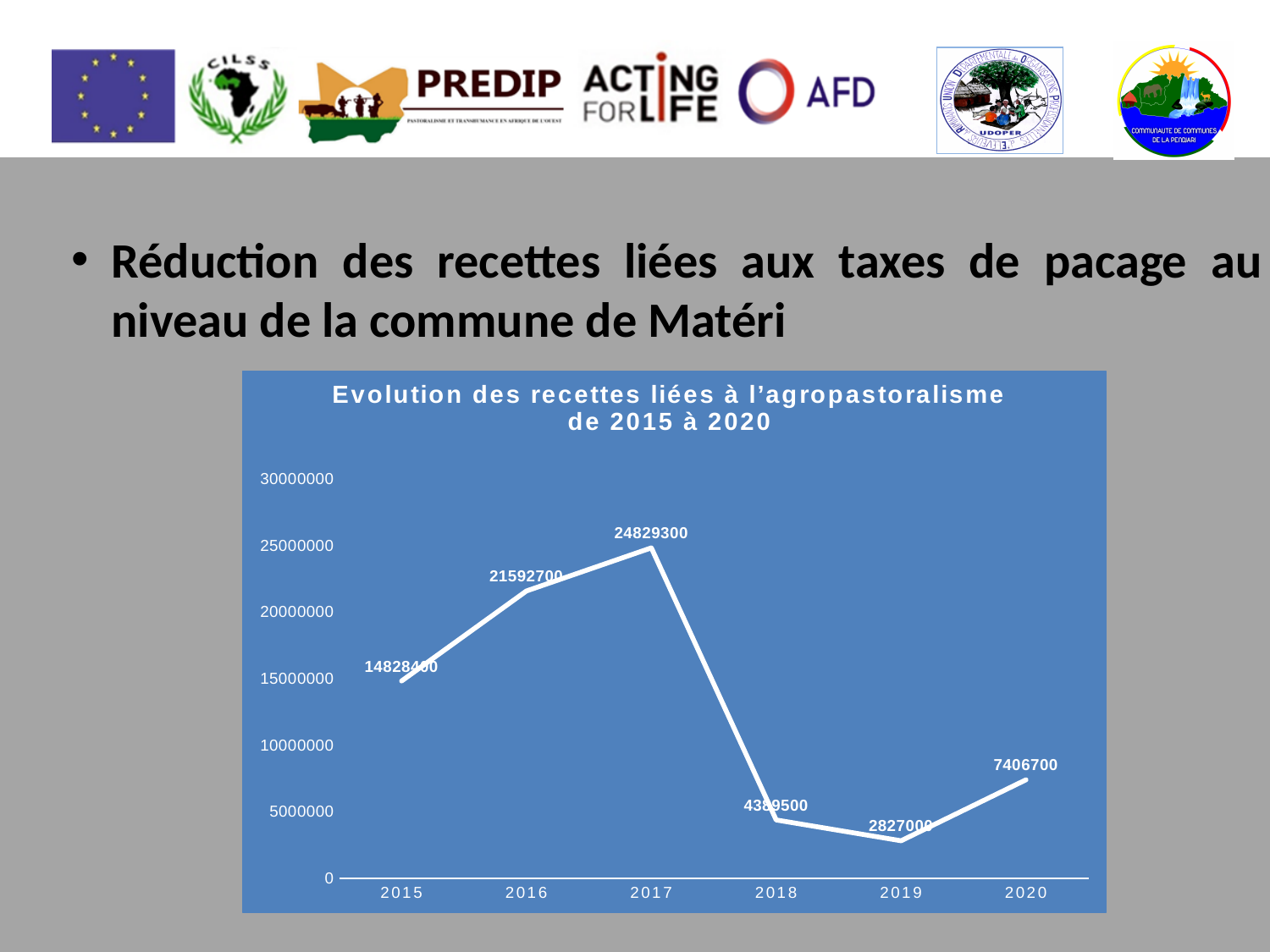
Do the values rise or fall from 2017 to 2019? fall Which year has the highest value? 2017 What is the value for 2020? 7406700 What is the value for 2016? 21592700 Which is larger, the value for 2016 or the value for 2020? 2016 How many years are plotted on the x axis? 6 What is the title of the chart? Evolution des recettes liées à l'agropastoralisme de 2015 à 2020 Which year has the lowest value? 2019 What is the value for 2017? 24829300 What type of chart is shown on the slide? line chart Is the value for 2018 greater or less than 5000000? less What is the difference between the values for 2017 and 2016? 3236600